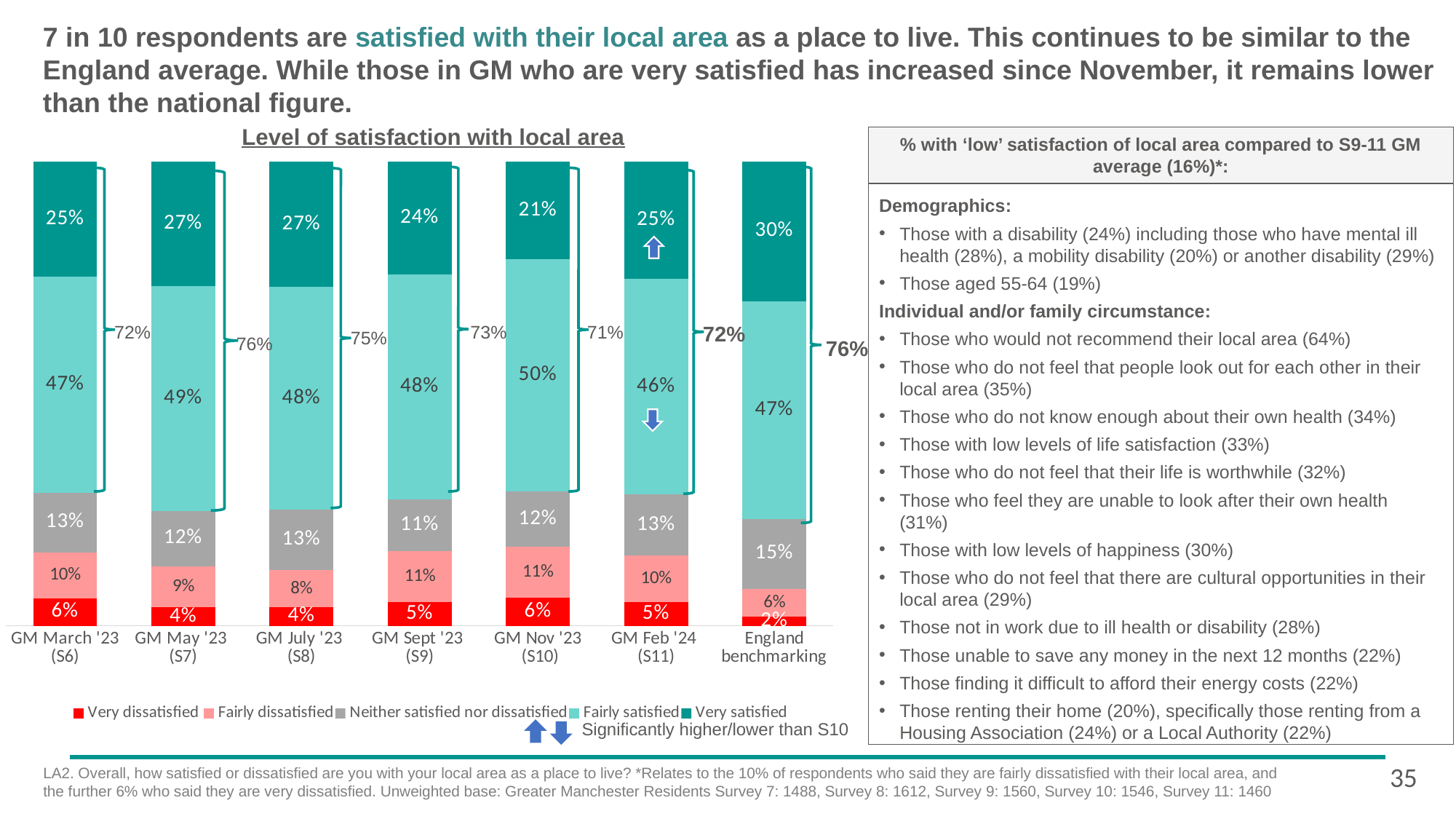
What is the combined Fairly satisfied and Very satisfied share for GM Feb '24 (S11)? 71% By how many percentage points did the Very satisfied share for GM Feb '24 (S11) exceed that for GM Nov '23 (S10)? 4 percentage points Which bar has the lowest Very dissatisfied percentage? England benchmarking What type of chart is used to show the level of satisfaction with local area? Stacked bar chart How many series does the legend list? 5 Which bar has the highest Very satisfied percentage? England benchmarking What is the Fairly dissatisfied value for GM July '23 (S8)? 8% Which has a larger Neither satisfied nor dissatisfied share: England benchmarking or GM Feb '24 (S11)? England benchmarking How many bars (survey waves/benchmarks) are shown in the chart? 7 What is the Fairly satisfied value for GM Nov '23 (S10)? 50% What percentage of respondents were very satisfied in the England benchmarking bar? 30% What is the Very dissatisfied value for GM March '23 (S6)? 6%